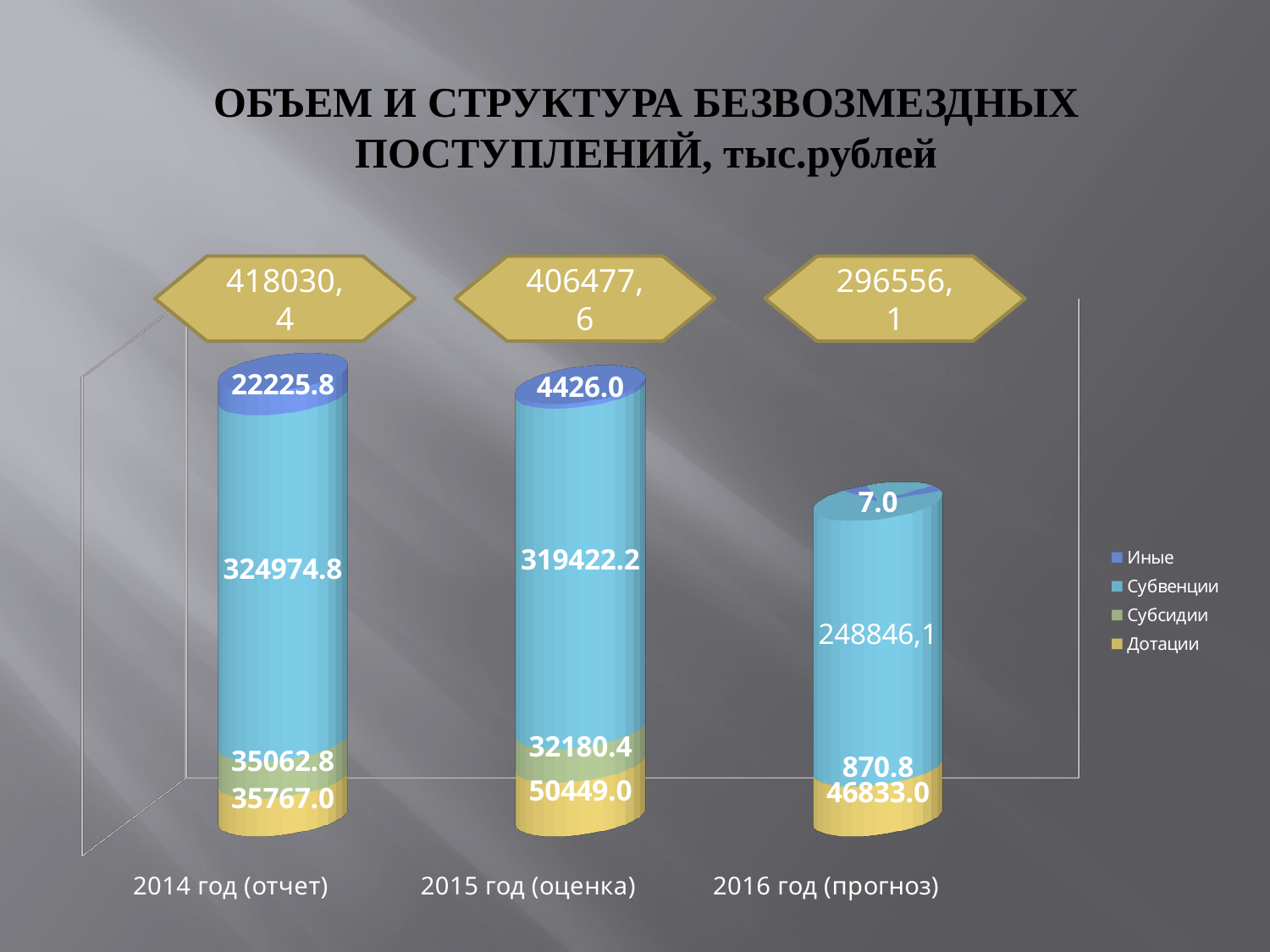
How many years (categories) are shown on the x axis? 3 What is the value for Субвенции in 2014 год (отчет)? 324974.8 What is the difference between Дотации in 2015 год (оценка) and Дотации in 2014 год (отчет)? 14682.0 What kind of chart is shown on the slide? Stacked bar chart Which year has the highest value for Субвенции? 2014 год (отчет) What is the value for Дотации in 2016 год (прогноз)? 46833.0 Do the values for Субвенции rise or fall from 2014 to 2016? Fall How many series does the legend list? 4 Which is larger: Субсидии in 2014 год (отчет) or Субсидии in 2015 год (оценка)? 2014 год (отчет) What is the value for Субсидии in 2015 год (оценка)? 32180.4 Which year has the lowest value for Иные? 2016 год (прогноз) What is the value for Иные in 2015 год (оценка)? 4426.0